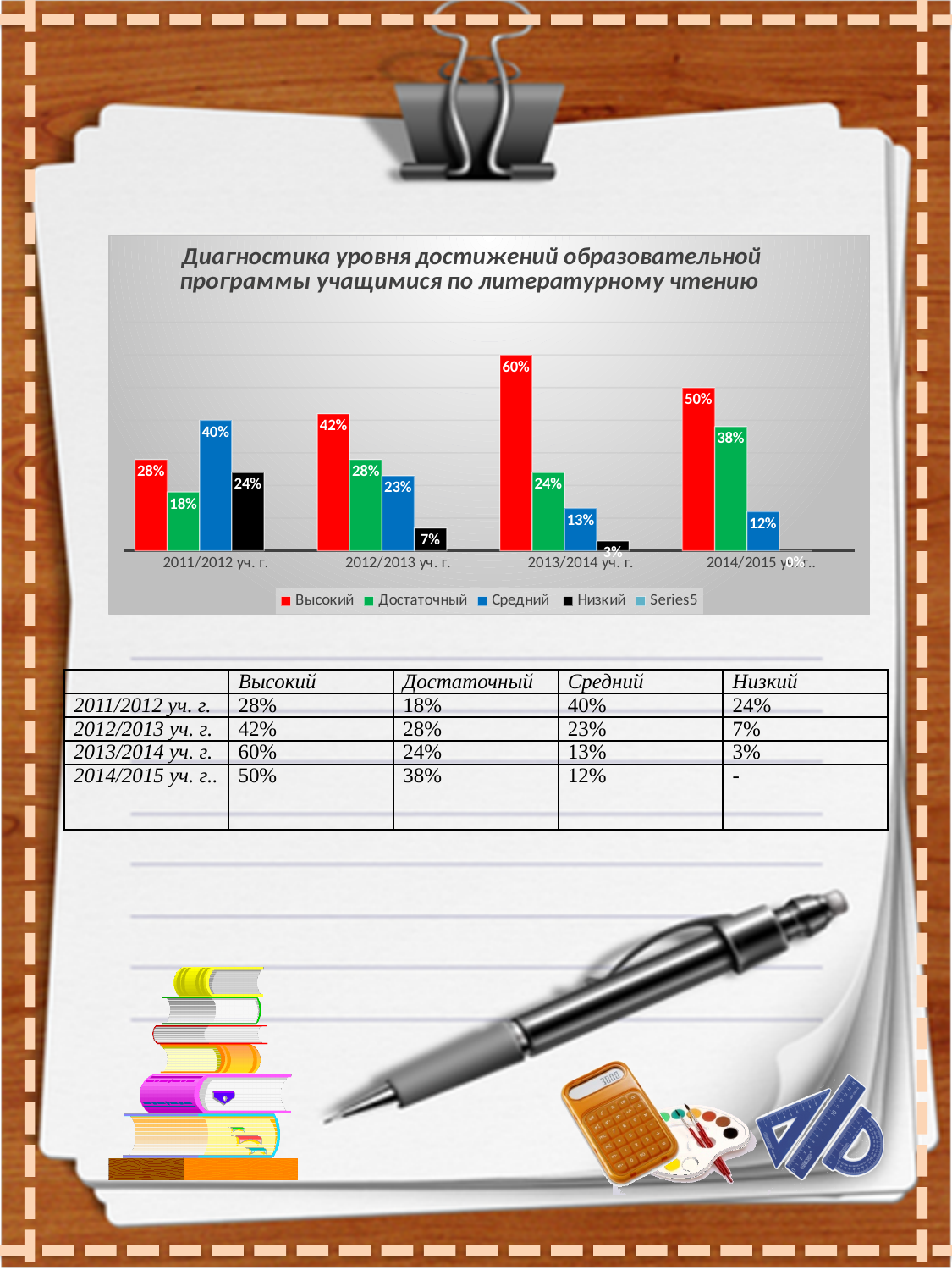
How many academic years are shown on the x axis? 4 Does the Средний value rise or fall from 2011/2012 уч. г. to 2014/2015 уч. г..? Fall What is the value for Низкий in 2012/2013 уч. г.? 7% What is the value for Достаточный in 2014/2015 уч. г..? 38% Which is larger in 2012/2013 уч. г.: Достаточный or Средний? Достаточный In which academic year is the Высокий value the highest? 2013/2014 уч. г. What is the value for Высокий in 2013/2014 уч. г.? 60% What is the difference between the Высокий values for 2013/2014 уч. г. and 2011/2012 уч. г.? 32% In which academic year is the Средний value the lowest? 2014/2015 уч. г.. What kind of chart is shown on the slide? Bar chart What is the value for Средний in 2011/2012 уч. г.? 40% How many series does the legend list? 5